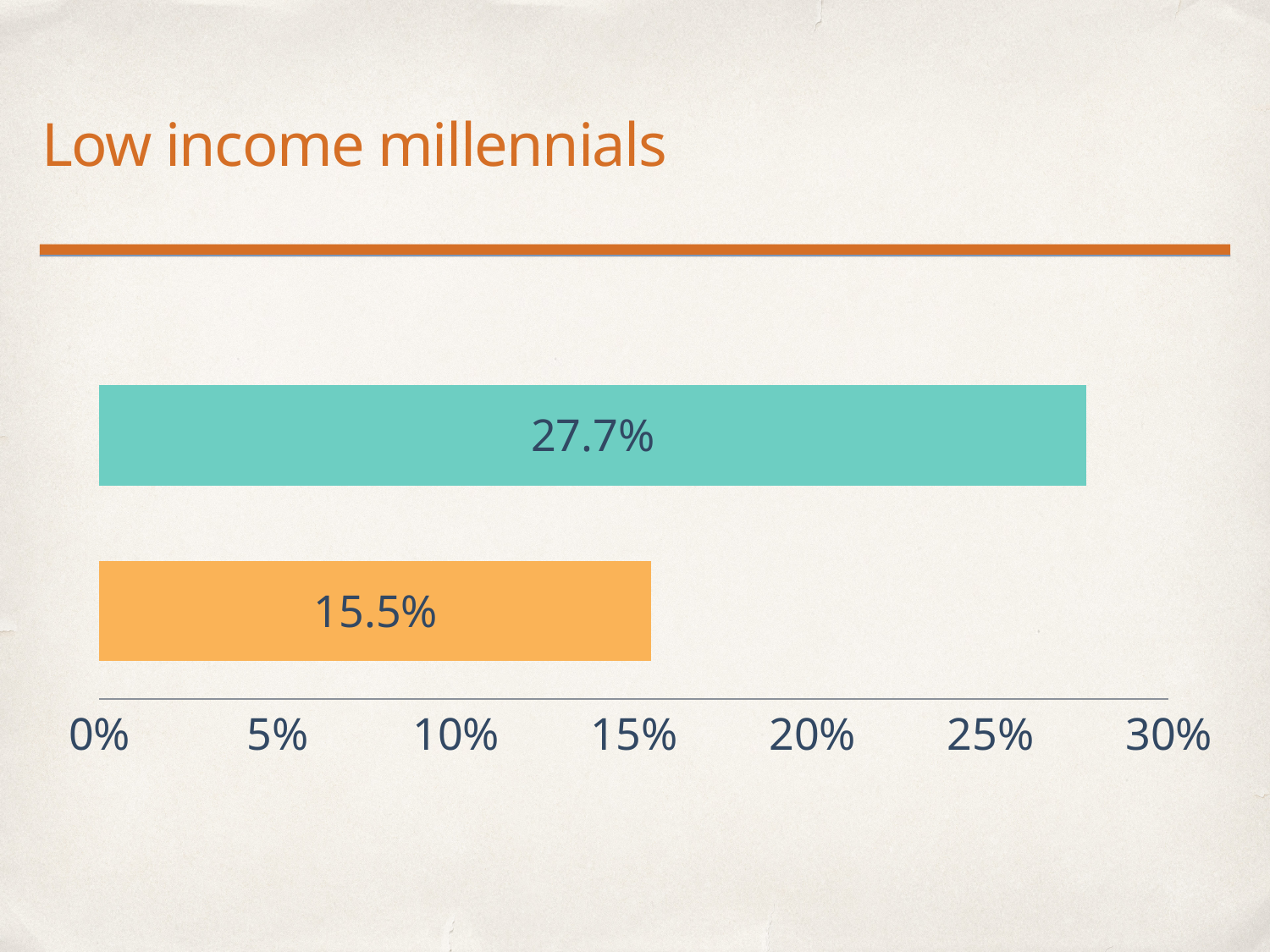
What kind of chart is shown on the slide? bar chart What is the difference between the top bar's value and the bottom bar's value? 12.2% Which bar shows the highest value? the top teal bar (27.7%) What is the value shown on the top (teal) bar? 27.7% Which bar has the higher value, the top teal bar or the bottom orange bar? the top teal bar Is the value of the top teal bar greater or less than 25%? greater What is the title of the slide containing the chart? Low income millennials Which bar shows the lowest value? the bottom orange bar (15.5%) What is the maximum value shown on the chart's horizontal axis? 30% Is the value of the bottom orange bar greater or less than 20%? less How many bars are plotted in the chart? 2 What is the value shown on the bottom (orange) bar? 15.5%